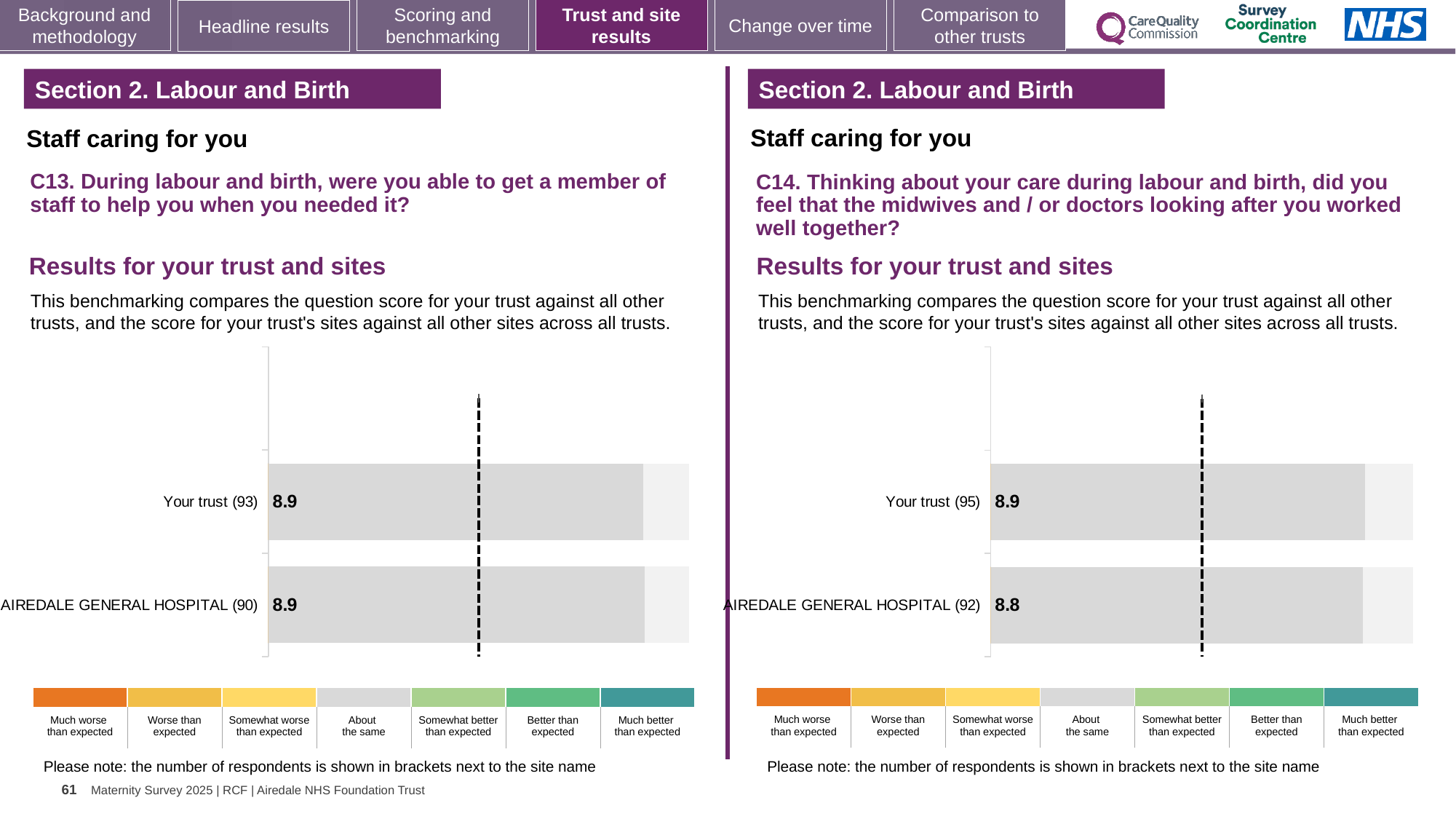
In the C13 chart on the left, what is the score for Your trust (93)? 8.9 How many respondents are shown in brackets for AIREDALE GENERAL HOSPITAL in the C14 chart on the right? 92 In the C14 chart on the right, what is the score for AIREDALE GENERAL HOSPITAL (92)? 8.8 In the C14 chart on the right, which row has the higher score? Your trust (95) In the C14 chart on the right, what is the score for Your trust (95)? 8.9 What type of chart is used for the C14 results on the right? Bar chart How many benchmark categories are shown in the colour key below the C13 chart on the left? 7 In the C13 chart on the left, what is the score for AIREDALE GENERAL HOSPITAL (90)? 8.9 In the C13 chart on the left, is the score for Your trust (93) larger than, smaller than, or equal to the score for AIREDALE GENERAL HOSPITAL (90)? equal How many bars are plotted in the C13 chart on the left? 2 How many bars are plotted in the C14 chart on the right? 2 In the C14 chart on the right, what is the difference between the score for Your trust (95) and the score for AIREDALE GENERAL HOSPITAL (92)? 0.1